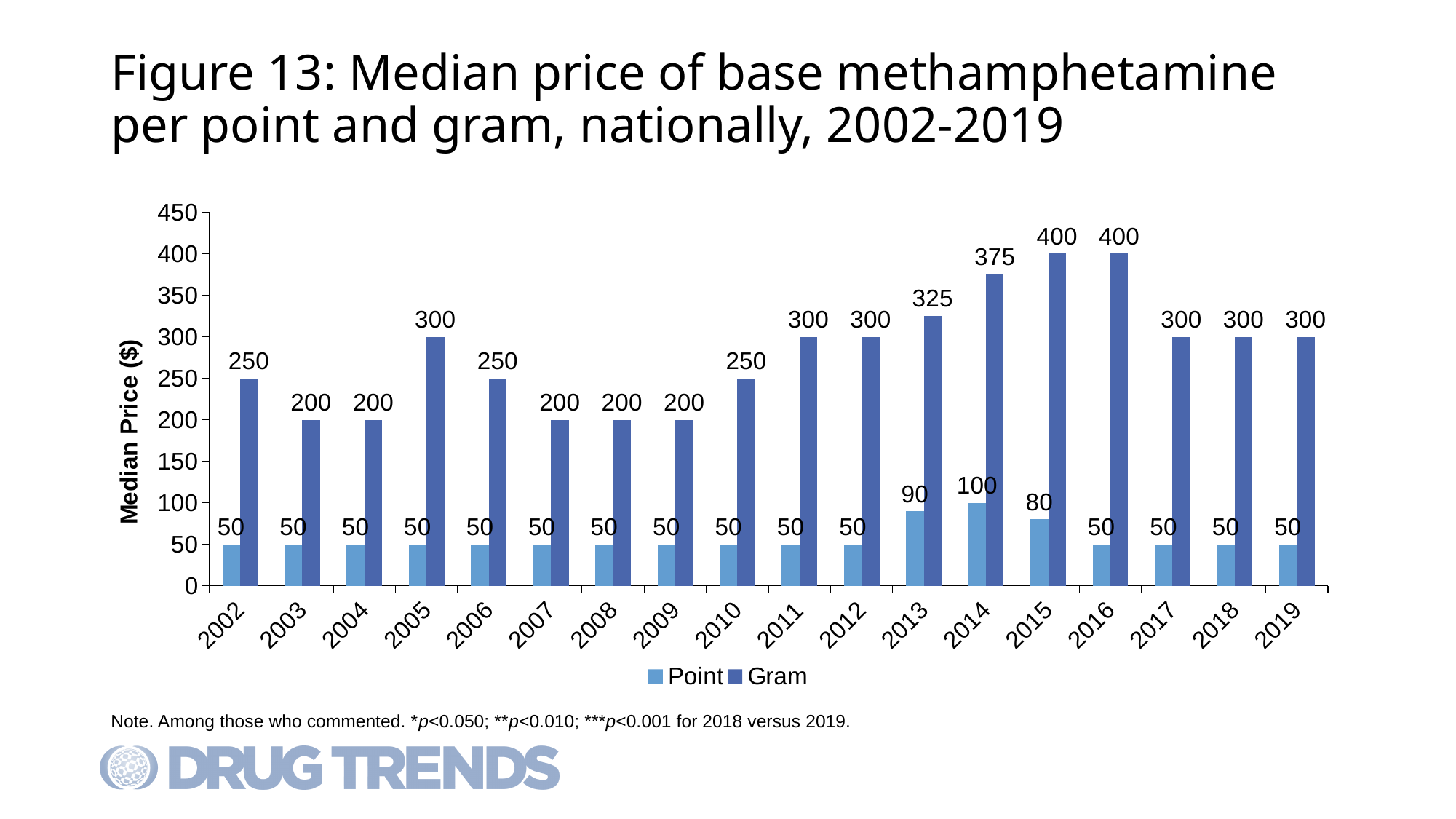
In which year is the median price per point highest? 2014 How many series does the legend list? 2 How many years are shown on the x axis? 18 Is the median price per gram in 2013 greater or less than 300? greater What is the difference between the median price per gram in 2016 and in 2017? 100 What is the label of the y axis? Median Price ($) What is the lowest median price per gram shown on the chart? 200 What is the median price per point in 2013? 90 Which is larger, the median price per gram in 2005 or in 2006? 2005 What is the median price per gram in 2014? 375 What kind of chart is shown on the slide? bar chart What is the median price per point in 2015? 80